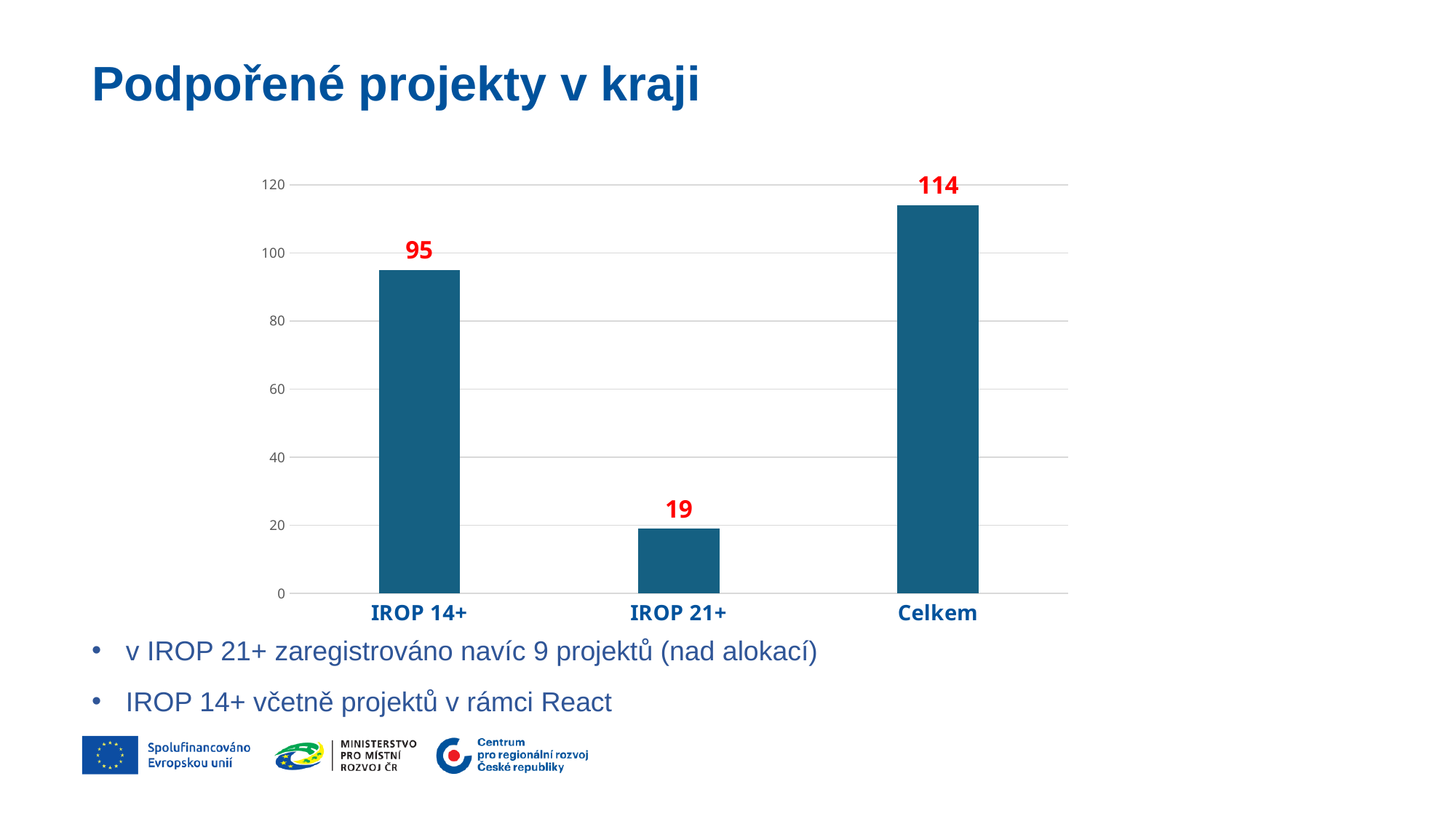
What is the value for IROP 14+? 95 Which category has the lowest value? IROP 21+ What is the difference between the values for Celkem and IROP 14+? 19 What kind of chart is shown on the slide? bar chart How many categories are shown on the x axis? 3 Which is larger, the value for IROP 14+ or the value for IROP 21+? IROP 14+ What is the difference between the values for IROP 14+ and IROP 21+? 76 Is the value for IROP 21+ greater or less than 40? less Which category has the highest value? Celkem What is the value for IROP 21+? 19 What is the title of the slide containing the chart? Podpořené projekty v kraji What is the value for Celkem? 114